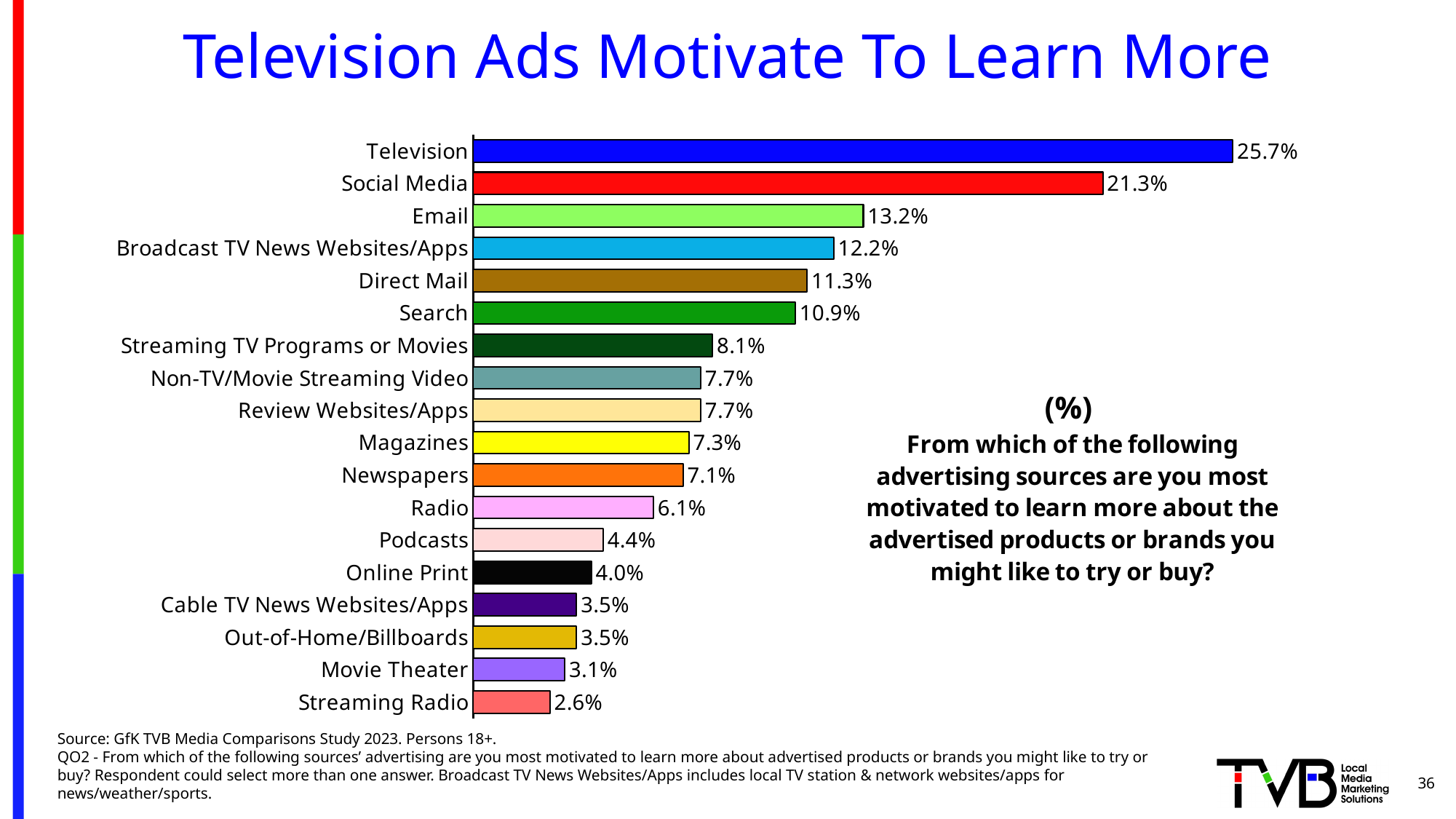
What kind of chart is shown on the slide? Bar chart What is the value for Direct Mail? 11.3% What is the value for Television? 25.7% What is the difference between the values for Email and Search? 2.3% Which is larger, the value for Broadcast TV News Websites/Apps or the value for Cable TV News Websites/Apps? Broadcast TV News Websites/Apps Which category has the lowest value? Streaming Radio What is the title of the slide? Television Ads Motivate To Learn More Which is larger, the value for Magazines or the value for Radio? Magazines Which category has the highest value? Television What is the difference between the values for Television and Social Media? 4.4% How many categories are shown in the chart? 18 What is the value for Podcasts? 4.4%